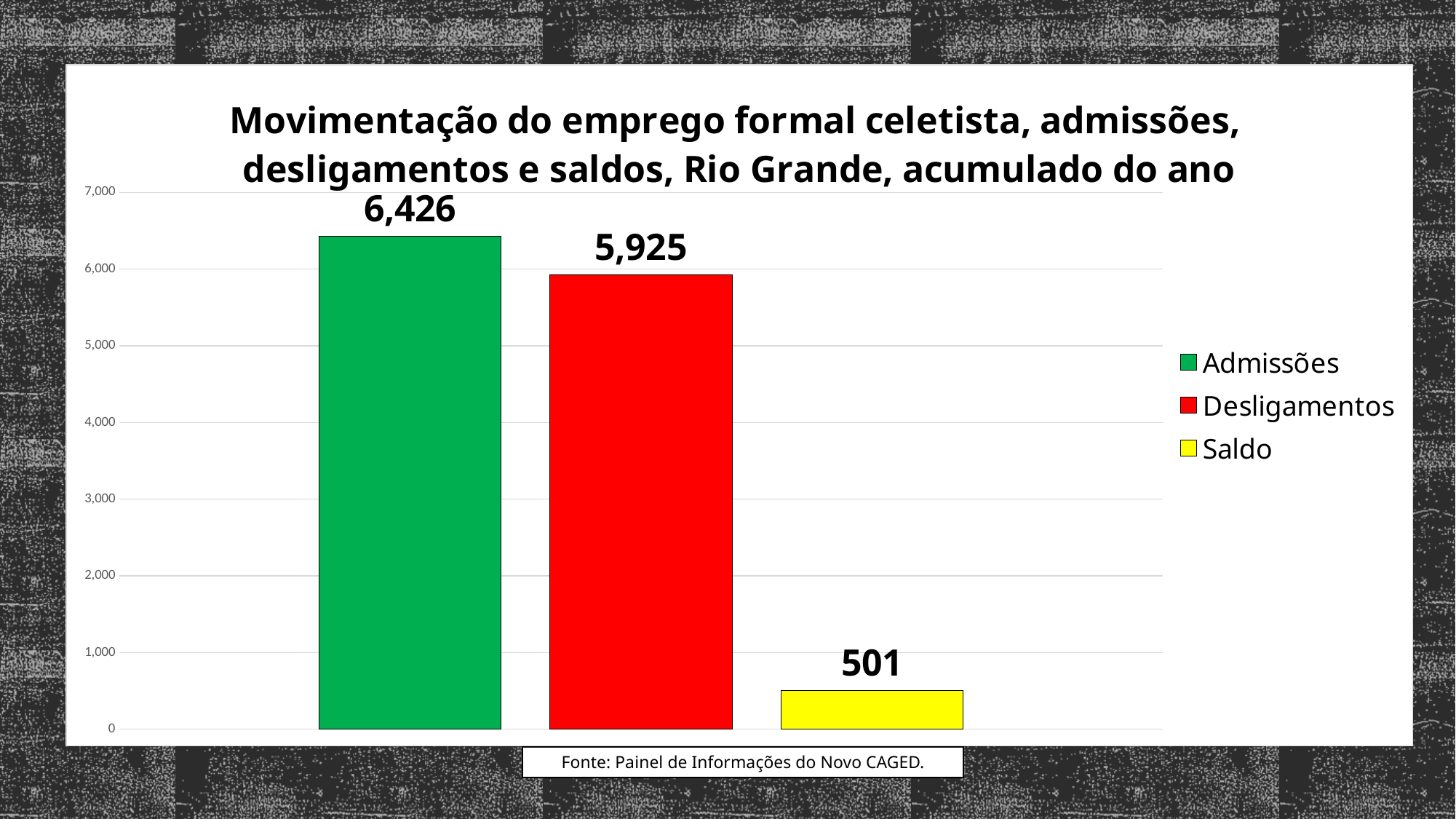
How many bars are plotted in the chart? 3 What kind of chart is shown on the slide? bar chart What is the value for Admissões? 6,426 Is the value for Desligamentos greater or less than 6,000? less Which series has the highest value? Admissões What is the value for Saldo? 501 What colour is the bar for Saldo? yellow Which is larger, Admissões or Desligamentos? Admissões How many series does the legend list? 3 What is the value for Desligamentos? 5,925 What is the difference between Admissões and Desligamentos? 501 Which series has the lowest value? Saldo